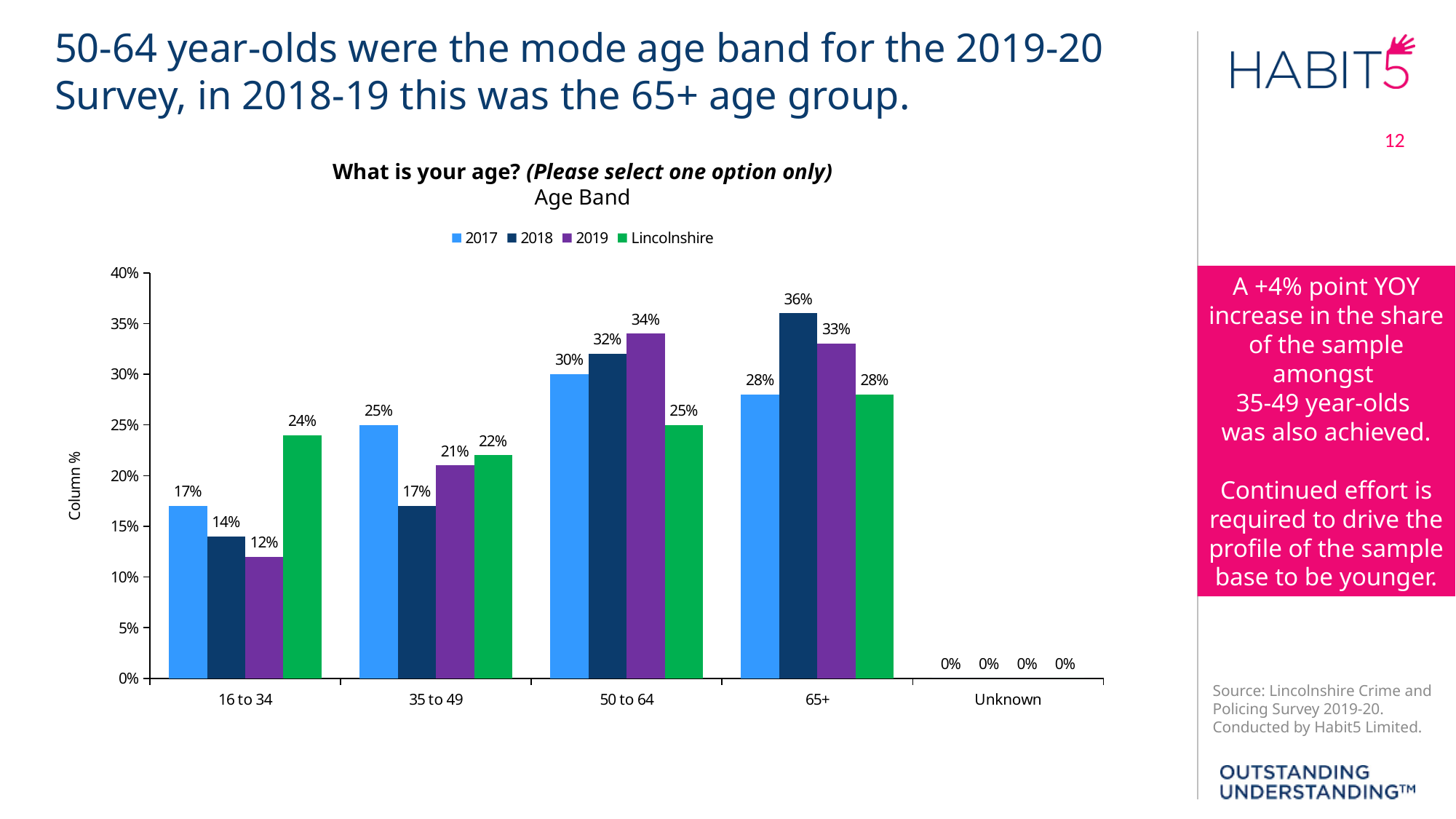
What kind of chart is shown on the slide? Bar chart Which age band has the lowest 2019 value, excluding Unknown? 16 to 34 What is the label of the y axis? Column % How many age band categories are shown on the x axis? 5 What is the Lincolnshire value for the 16 to 34 age band? 24% What is the 2018 value for the 65+ age band? 36% Which age band has the highest 2019 value? 50 to 64 Which is larger for the 65+ age band, the 2018 value or the 2019 value? 2018 What is the difference between the 2017 and 2019 values for the 16 to 34 age band? 5% What is the difference between the 2019 and 2018 values for the 35 to 49 age band? 4% How many series does the legend list? 4 What is the 2019 value for the 50 to 64 age band? 34%